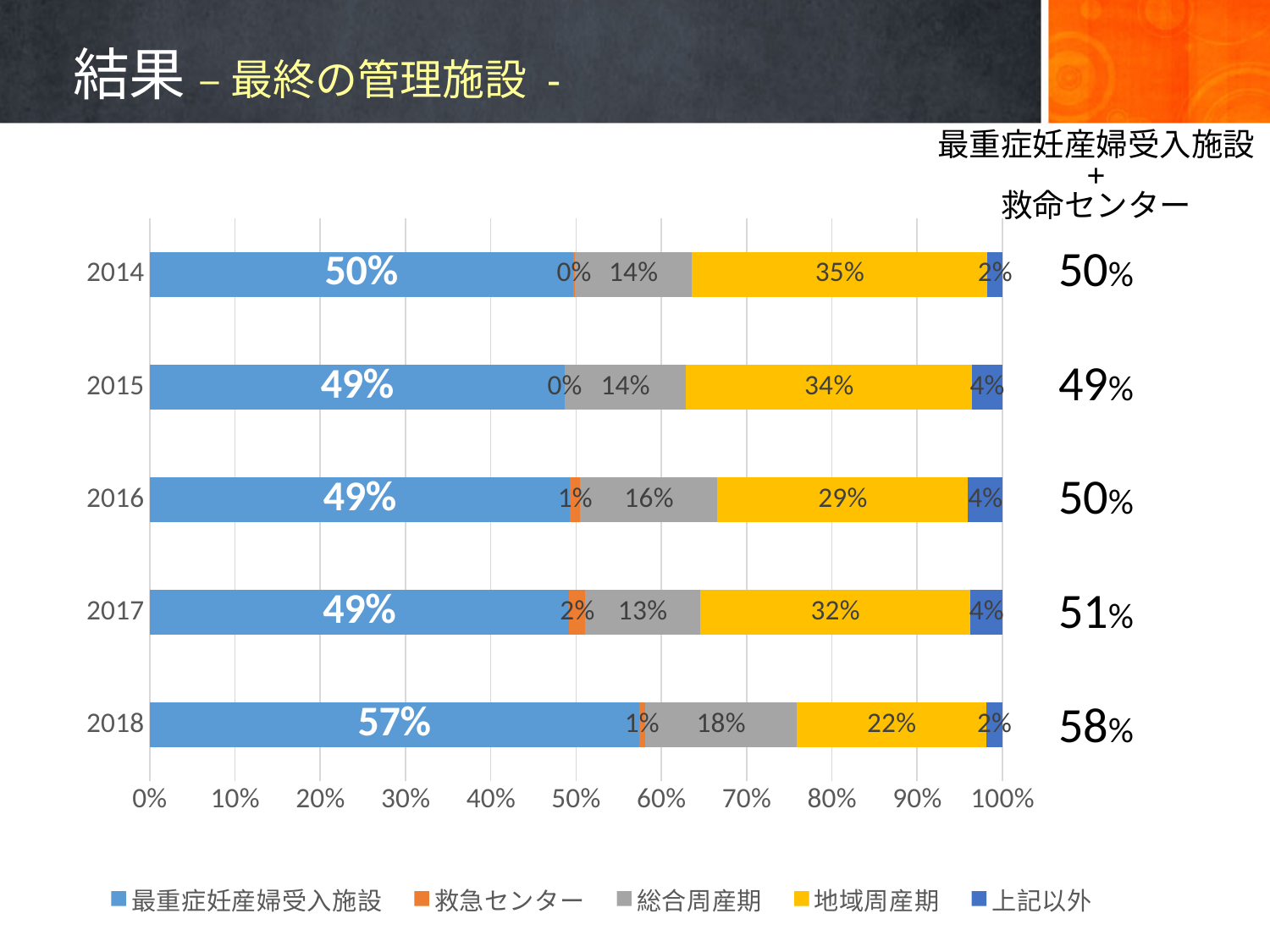
What kind of chart is shown on the slide? stacked bar chart What is the difference between the 地域周産期 values for 2014 and 2018? 13% What is the value for 救急センター in 2017? 2% Which year has the lowest value for 地域周産期? 2018 How many years (categories) are plotted on the chart? 5 What is the value for 総合周産期 in 2016? 16% What is the value for 最重症妊産婦受入施設 in 2018? 57% Which year has the highest value for 最重症妊産婦受入施設? 2018 Which series is shown in yellow in the legend? 地域周産期 What is the value for 地域周産期 in 2014? 35% How many series does the legend list? 5 Which is larger, the 総合周産期 value for 2017 or for 2018? 2018